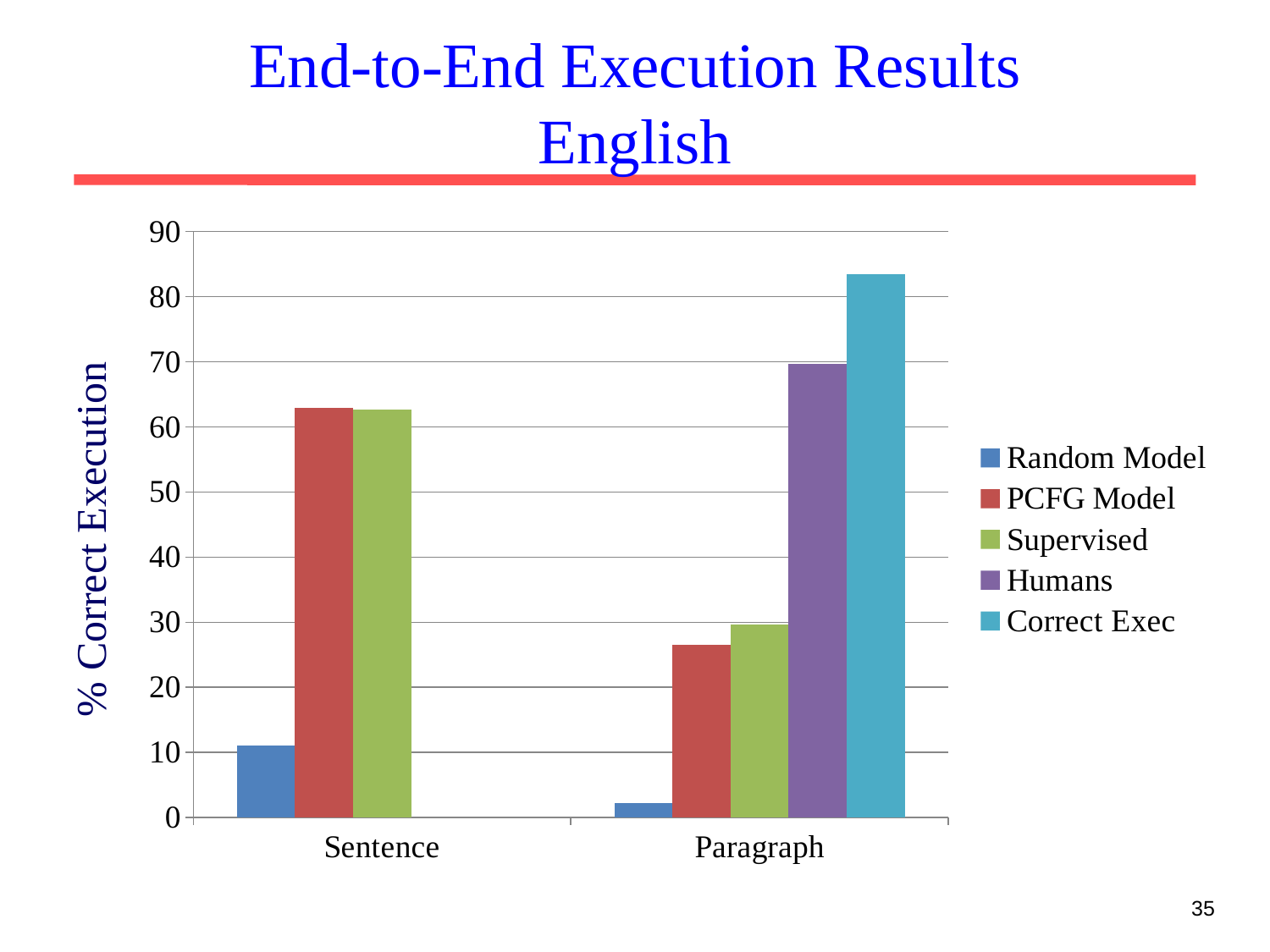
How many categories are shown on the x axis? 2 What is the label of the y axis? % Correct Execution Is the value for Random Model in Sentence greater or less than 20? less Is the value for Correct Exec in Paragraph greater or less than 80? greater Is the value for Humans in Paragraph greater or less than 60? greater Which series has the lowest value for Paragraph? Random Model What kind of chart is shown on the slide? bar chart Which series has the highest value for Paragraph? Correct Exec How many series does the legend list? 5 Which series has the lowest value for Sentence? Random Model Which is larger for the PCFG Model, the Sentence value or the Paragraph value? Sentence Which is larger for Paragraph, the PCFG Model value or the Humans value? Humans